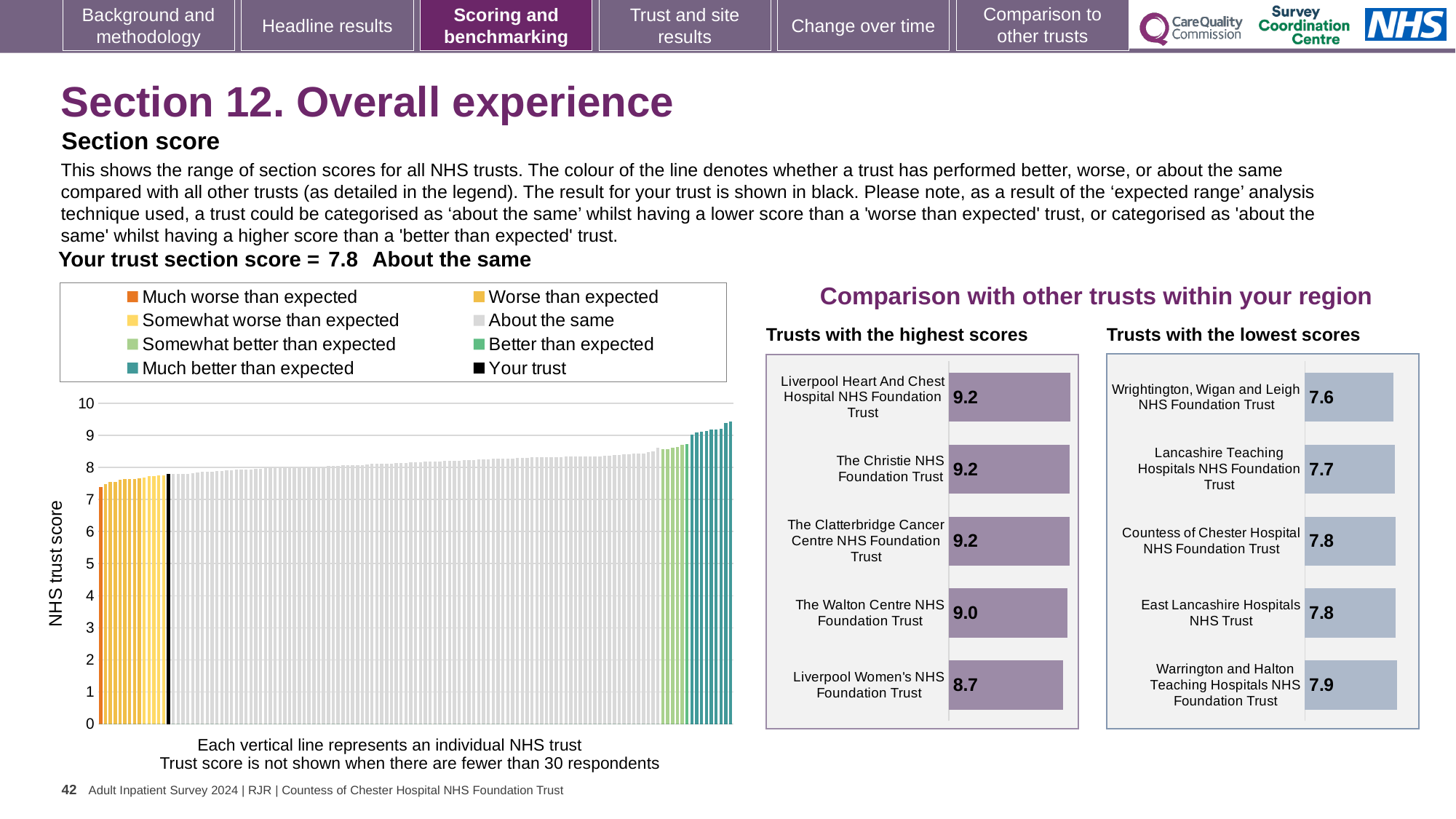
In the 'Trusts with the lowest scores' chart, which has the larger score: Lancashire Teaching Hospitals NHS Foundation Trust or Warrington and Halton Teaching Hospitals NHS Foundation Trust? Warrington and Halton Teaching Hospitals NHS Foundation Trust In the main NHS trust score chart on the left, what is the section score for your trust? 7.8 In the 'Trusts with the lowest scores' chart, which trust has the highest score? Warrington and Halton Teaching Hospitals NHS Foundation Trust In the main NHS trust score chart on the left, do the trust scores rise or fall from left to right along the x axis? rise In the 'Trusts with the lowest scores' chart, what is the score for Wrightington, Wigan and Leigh NHS Foundation Trust? 7.6 In the main NHS trust score chart on the left, is the value of the rightmost (highest) trust greater or less than 9? greater In the 'Trusts with the highest scores' chart, what is the score for The Walton Centre NHS Foundation Trust? 9.0 How many entries does the legend of the main NHS trust score chart on the left list? 8 In the 'Trusts with the highest scores' chart, what is the score for Liverpool Women's NHS Foundation Trust? 8.7 In the 'Trusts with the highest scores' chart, what is the difference between the scores of The Walton Centre NHS Foundation Trust and Liverpool Women's NHS Foundation Trust? 0.3 In the 'Trusts with the highest scores' chart, which trust has the lowest score? Liverpool Women's NHS Foundation Trust How many trusts are shown in the 'Trusts with the lowest scores' chart? 5